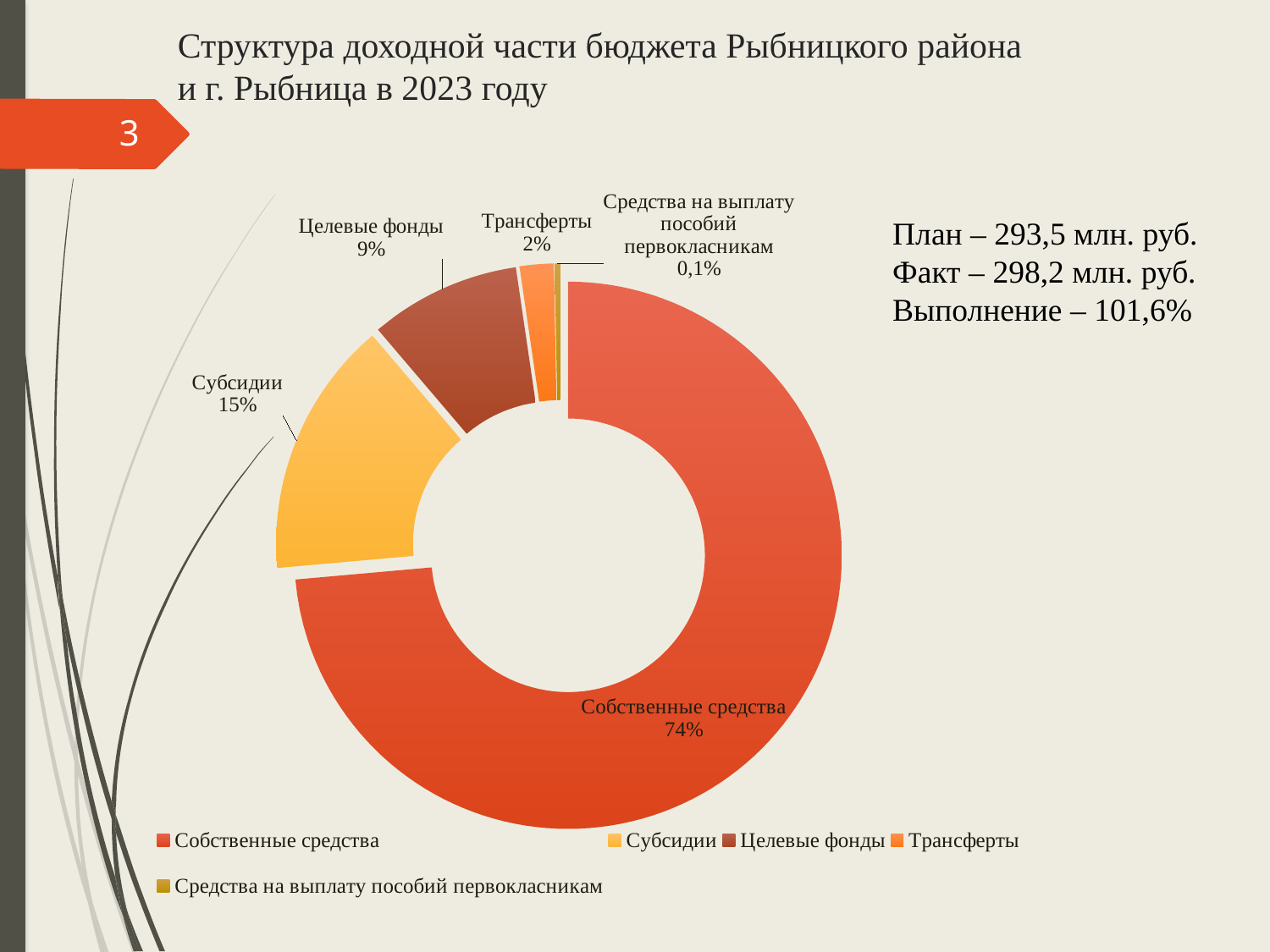
What is the value shown for Средства на выплату пособий первокласникам? 0,1% What is the value shown for Субсидии? 15% What is the value shown for Трансферты? 2% Which category has the smallest share of the chart? Средства на выплату пособий первокласникам Which category has the largest share of the chart? Собственные средства What kind of chart is shown on the slide? Pie chart (doughnut) What is the value shown for Целевые фонды? 9% What is the difference in percentage points between Субсидии and Целевые фонды? 6% Which is larger, Целевые фонды or Трансферты? Целевые фонды What share of the budget revenue does Собственные средства account for? 74% What is the title of the slide? Структура доходной части бюджета Рыбницкого района и г. Рыбница в 2023 году How many categories are shown in the chart? 5